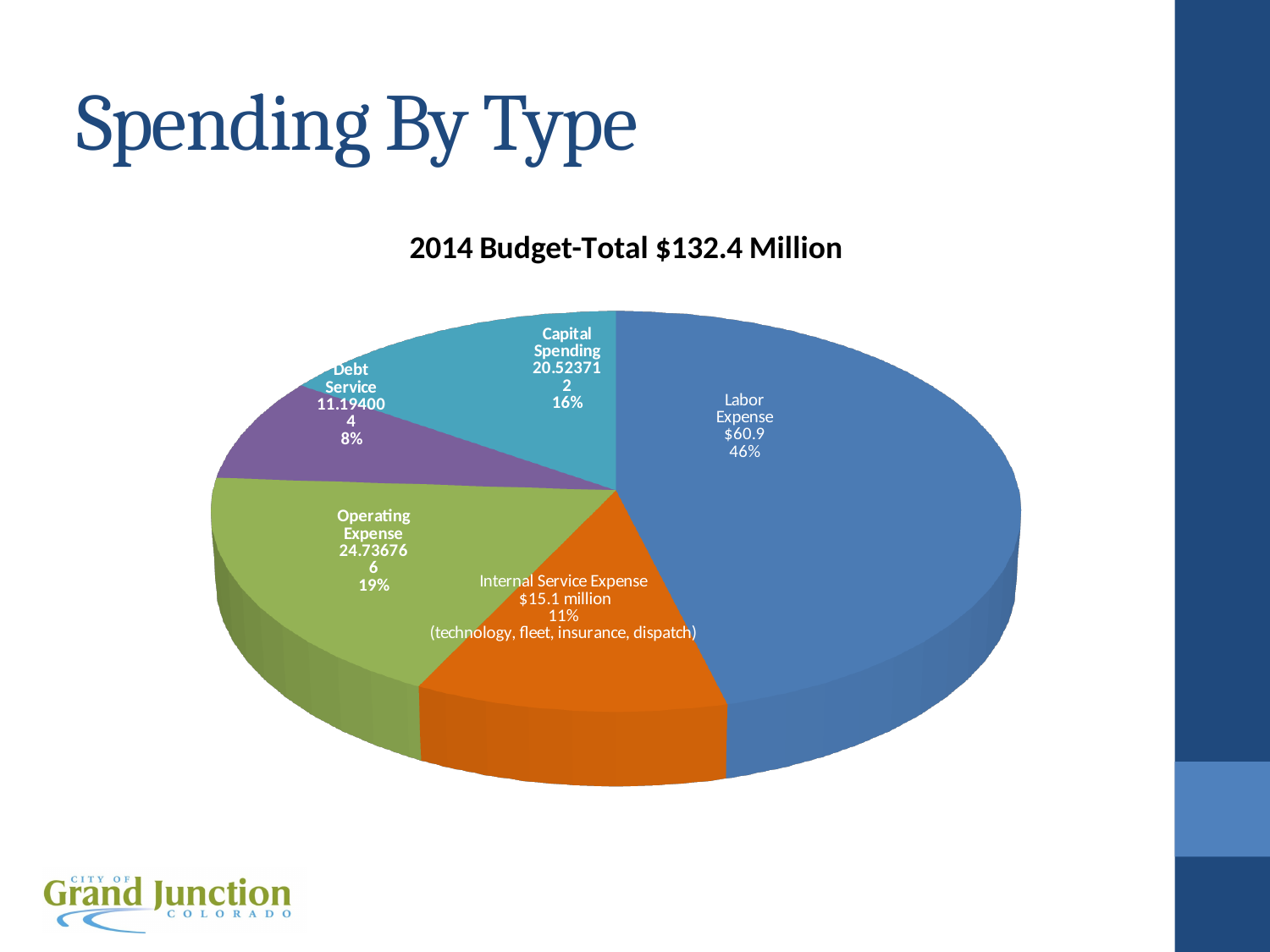
Which category has the largest share of the pie? Labor Expense What percentage of the pie does Operating Expense represent? 19% What percentage of the pie does Internal Service Expense represent? 11% What percentage of the pie does Labor Expense represent? 46% What type of chart is shown on the slide? pie chart What is the title of the chart? 2014 Budget-Total $132.4 Million What is the value shown for Labor Expense? $60.9 Which category has the smallest share of the pie? Debt Service What is the value shown for Internal Service Expense? $15.1 million How many slices does the pie chart have? 5